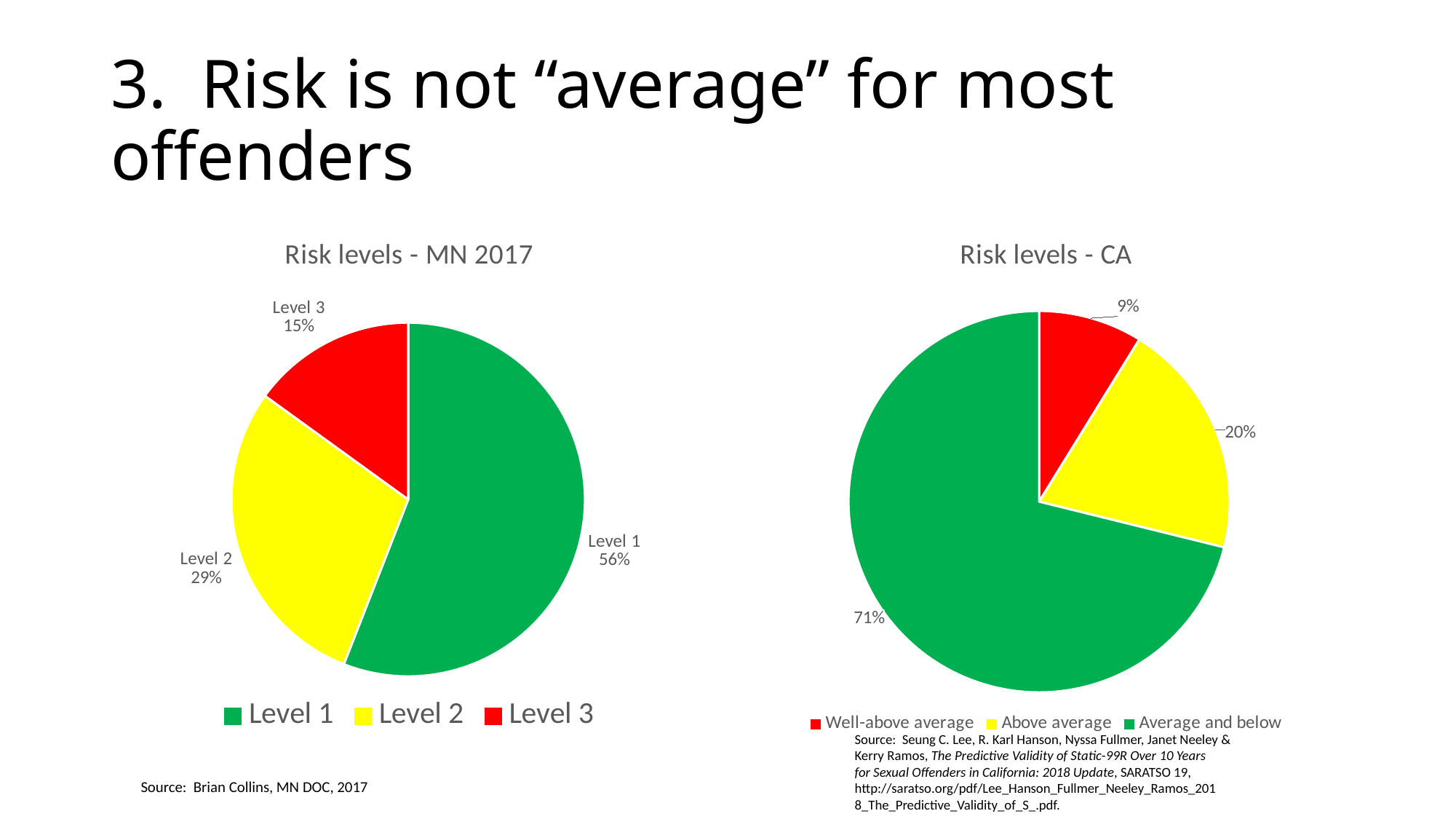
In the 'Risk levels - MN 2017' chart, how many slices does the pie have? 3 In the 'Risk levels - MN 2017' chart, what is the difference between the Level 1 and Level 2 shares? 27% In the 'Risk levels - CA' chart, which is larger: 'Above average' or 'Well-above average'? Above average What type of chart is 'Risk levels - MN 2017'? Pie chart In the 'Risk levels - MN 2017' chart, which level has the smallest share? Level 3 In the 'Risk levels - MN 2017' chart, what percentage is Level 1? 56% In the 'Risk levels - CA' chart, which category has the largest share? Average and below In the 'Risk levels - CA' chart, what percentage is 'Well-above average'? 9% In the 'Risk levels - CA' chart, what colour is the 'Above average' slice? Yellow In the 'Risk levels - CA' chart, what percentage is 'Average and below'? 71% In the 'Risk levels - CA' chart, what is the difference between the 'Above average' and 'Well-above average' shares? 11% In the 'Risk levels - MN 2017' chart, what percentage is Level 2? 29%